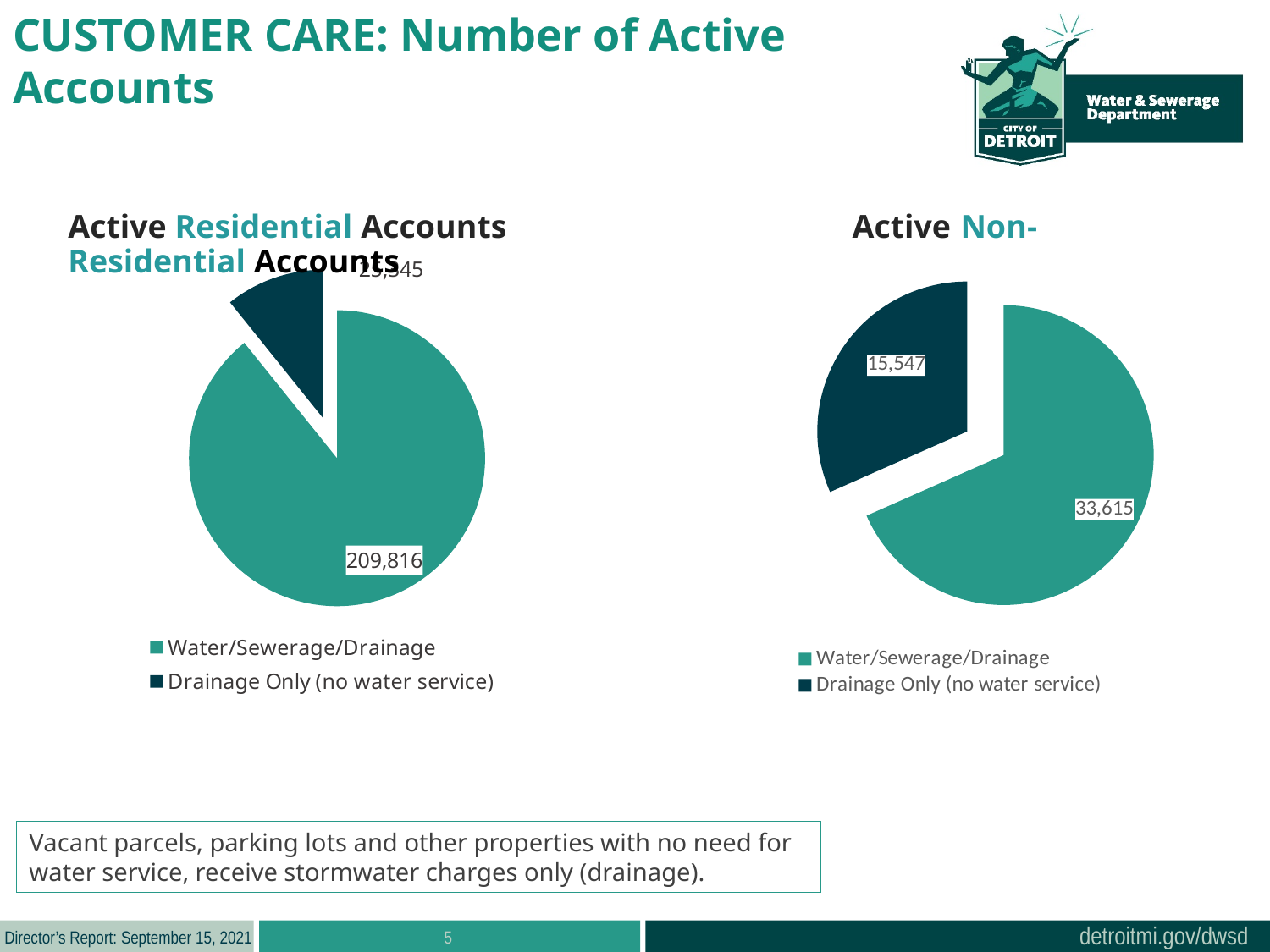
In the Active Non-Residential Accounts chart, which category has the smallest slice? Drainage Only (no water service) In the Active Non-Residential Accounts chart, what is the difference between the Water/Sewerage/Drainage and Drainage Only (no water service) values? 18,068 In the Active Non-Residential Accounts chart, what is the total of the two slices? 49,162 In the Active Residential Accounts chart, which category has the largest slice? Water/Sewerage/Drainage In the Active Non-Residential Accounts chart, what is the value for Drainage Only (no water service)? 15,547 What type of chart is the Active Residential Accounts chart? Pie chart In the Active Non-Residential Accounts chart, which is larger: Water/Sewerage/Drainage or Drainage Only (no water service)? Water/Sewerage/Drainage In the Active Non-Residential Accounts chart, what is the value for Water/Sewerage/Drainage? 33,615 In the Active Residential Accounts chart, what is the value for Water/Sewerage/Drainage? 209,816 How many slices does the Active Non-Residential Accounts pie chart have? 2 How many entries does the legend of the Active Residential Accounts chart list? 2 In the Active Non-Residential Accounts chart, what colour is the Drainage Only (no water service) slice? Dark teal (dark blue-green)